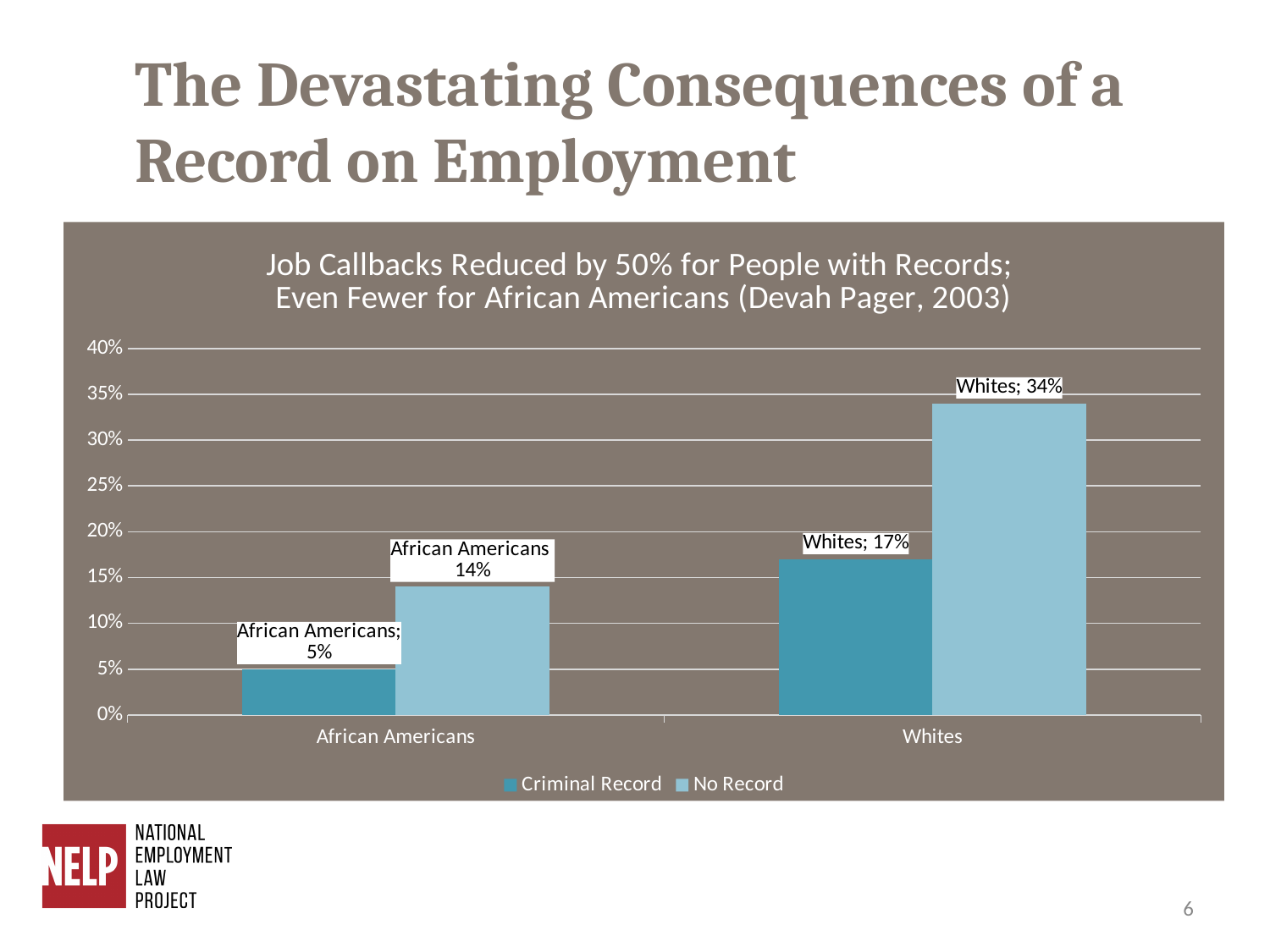
How many categories are shown on the x axis? 2 Which group and series combination has the lowest callback rate? African Americans, Criminal Record What is the difference between the No Record callback rate for Whites and for African Americans? 20% What is the callback rate for Whites with a criminal record? 17% Which is larger: the Criminal Record rate for Whites or the No Record rate for African Americans? Criminal Record rate for Whites What is the callback rate for African Americans with no record? 14% What is the difference between the No Record and Criminal Record callback rates for Whites? 17% What kind of chart is shown on the slide? Bar chart Which group and series combination has the highest callback rate? Whites, No Record How many series does the legend list? 2 What is the callback rate for African Americans with a criminal record? 5% What is the callback rate for Whites with no record? 34%